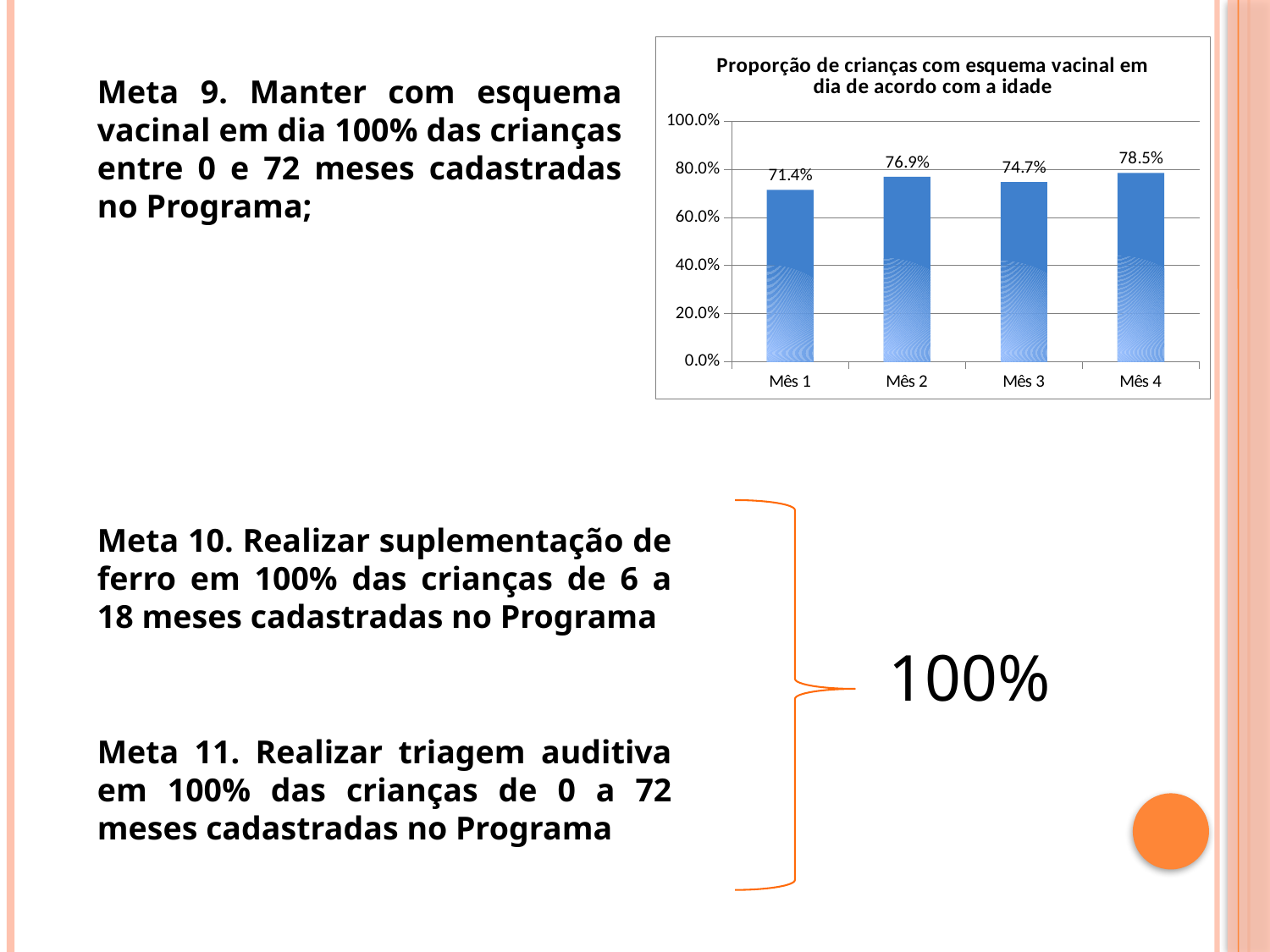
What is the title of the chart? Proporção de crianças com esquema vacinal em dia de acordo com a idade Which month has the lowest proportion? Mês 1 What is the difference between the values for Mês 4 and Mês 1? 7.1% Which is larger, the value for Mês 2 or the value for Mês 3? Mês 2 Is the value for Mês 1 greater or less than 80.0%? less Which month has the highest proportion? Mês 4 What is the value for Mês 4? 78.5% What kind of chart is shown? bar chart How many months are shown on the x axis? 4 What is the value for Mês 1? 71.4% What is the value for Mês 3? 74.7% What is the value for Mês 2? 76.9%